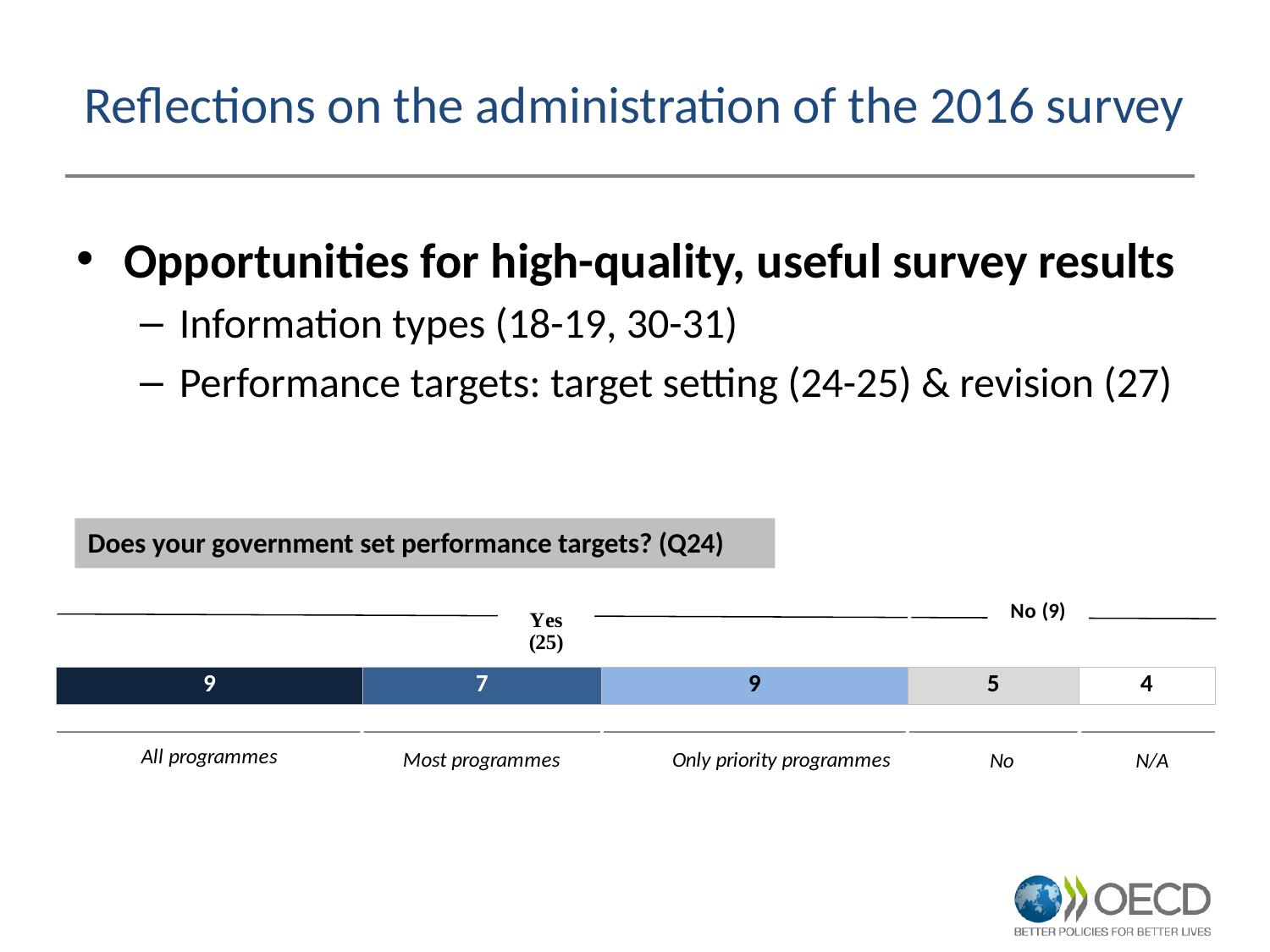
Which is larger, the value for "Only priority programmes" or the value for "No"? Only priority programmes What is the value for "Most programmes" in the chart? 7 What is the total of all segments in the stacked bar? 34 What is the value for "No" in the chart? 5 What is the difference between the values for "Most programmes" and "No"? 2 What total is shown for the "Yes" group above the bar? 25 What is the value for "All programmes" in the chart? 9 What is the title of the chart? Does your government set performance targets? (Q24) Which category has the lowest value in the chart? N/A What is the value for "N/A" in the chart? 4 How many categories are shown in the stacked bar? 5 What kind of chart is shown on the slide? Stacked bar chart